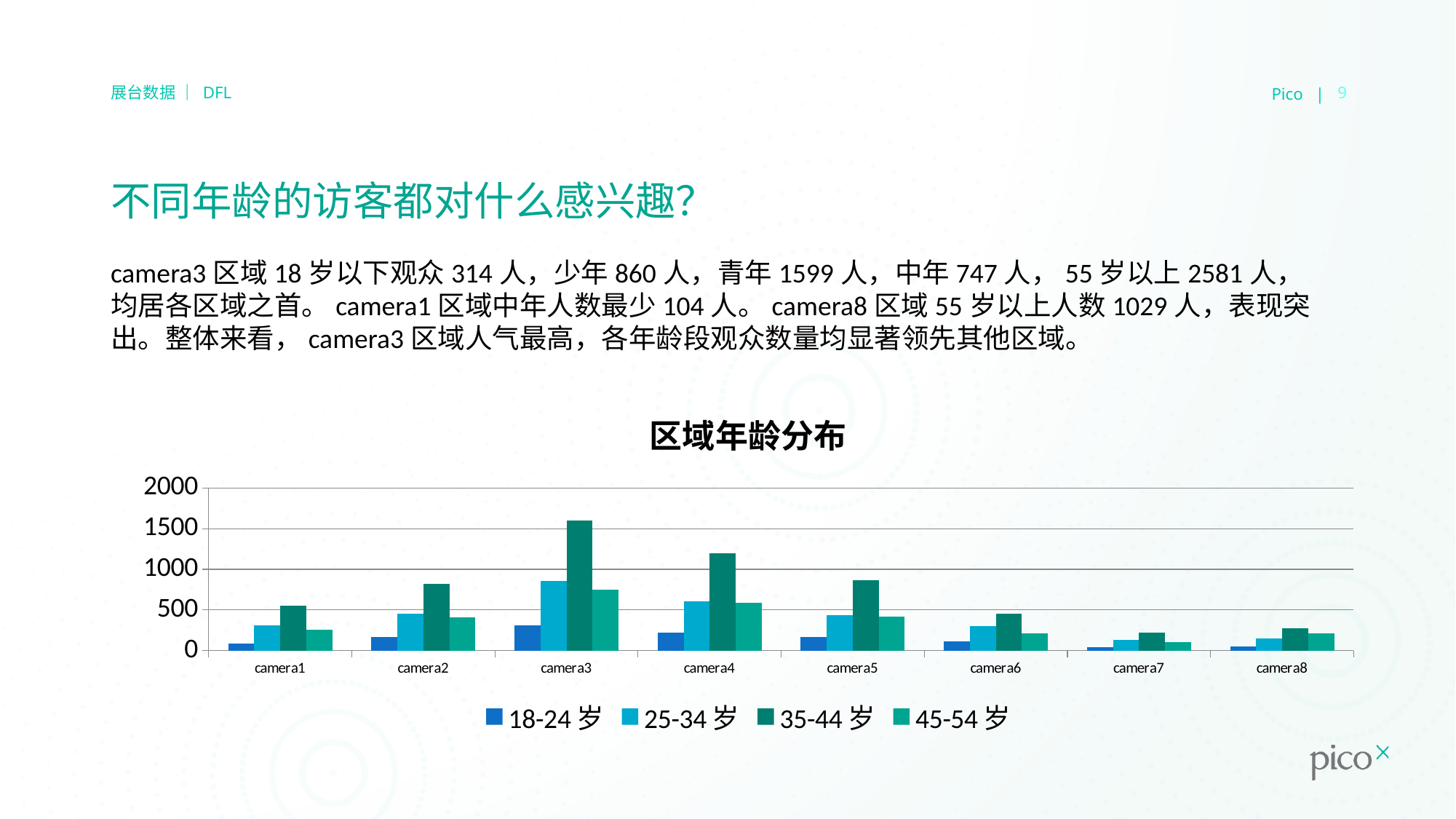
Which age series has the highest value at camera3? 35-44 岁 How many camera categories are shown on the x axis? 8 Which is larger, the 25-34 岁 value at camera2 or at camera3? camera3 Which is larger, the 35-44 岁 value at camera4 or at camera5? camera4 How many series does the legend list? 4 Is the value for 18-24 岁 at camera1 greater or less than 500? less Is the value for 35-44 岁 at camera4 greater or less than 1000? greater Which camera has the highest value for the 35-44 岁 series? camera3 What kind of chart is shown on the slide? bar chart What is the title of the chart? 区域年龄分布 Is the value for 35-44 岁 at camera3 greater or less than 1500? greater